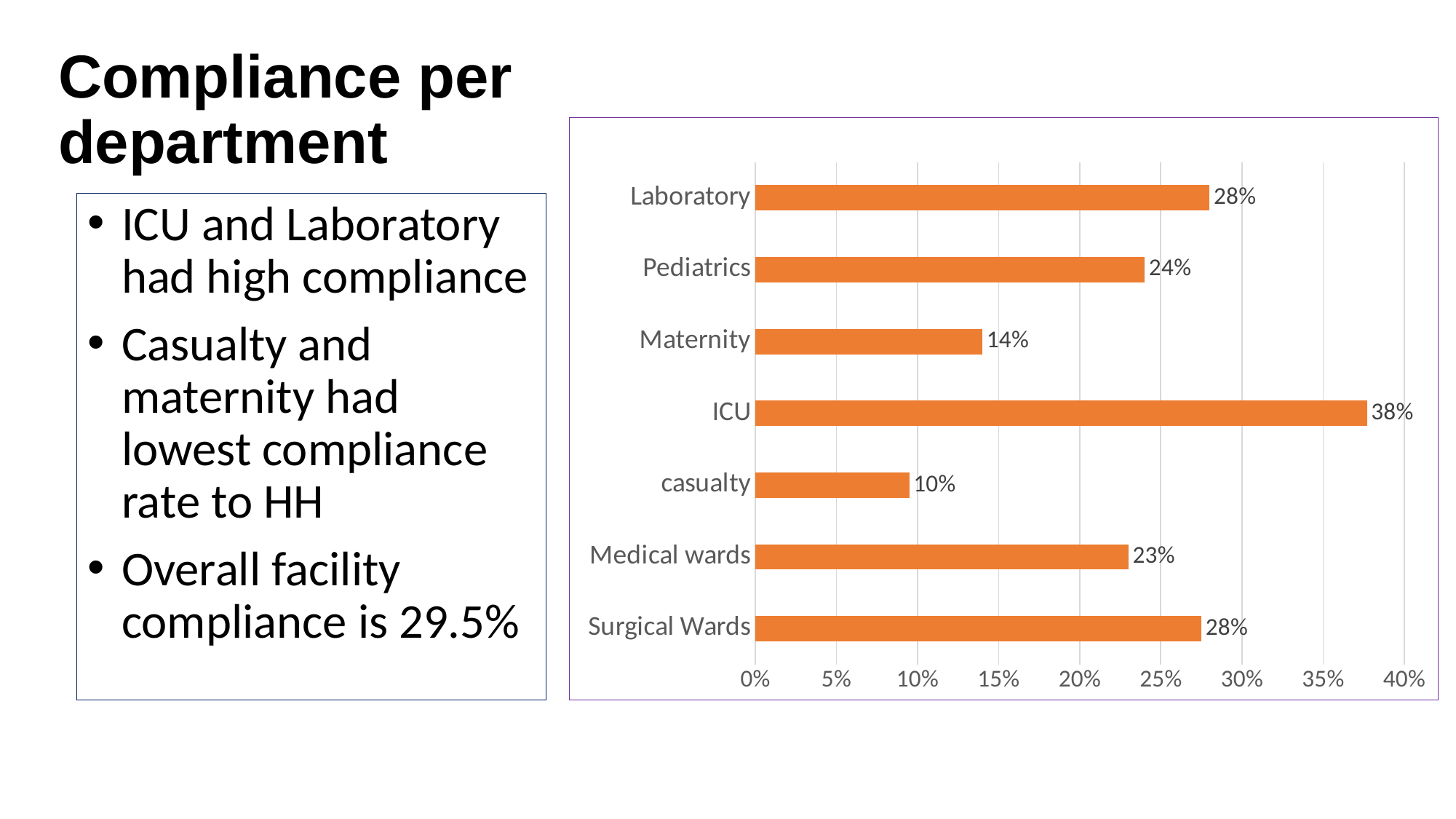
How many departments are shown in the chart? 7 Which department has the highest compliance? ICU What is the compliance value for Maternity? 14% What is the difference between the compliance values for Laboratory and Maternity? 14 percentage points What kind of chart is shown on the slide? bar chart Is the value for Surgical Wards greater or less than 25%? greater Which has a higher compliance value, Pediatrics or Maternity? Pediatrics What is the difference between the compliance values for ICU and casualty? 28 percentage points What is the compliance value for Pediatrics? 24% What is the compliance value for ICU? 38% Which department has the lowest compliance? casualty What is the compliance value for Medical wards? 23%